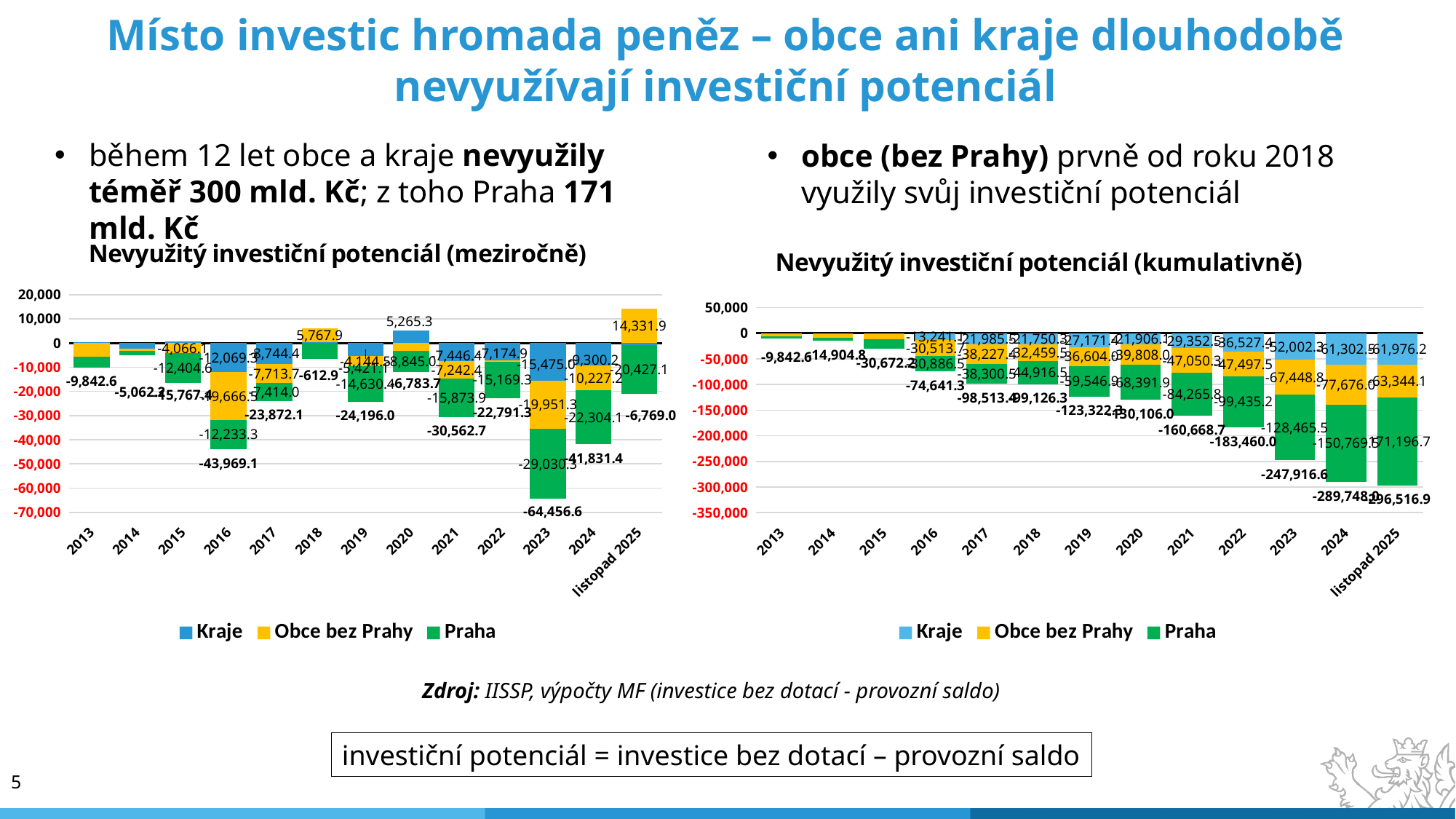
How many categories are shown on the x axis of the left chart 'Nevyužitý investiční potenciál (meziročně)'? 13 What kind of chart is the left chart titled 'Nevyužitý investiční potenciál (meziročně)'? stacked bar chart In the left chart 'Nevyužitý investiční potenciál (meziročně)', which year has the total closest to zero? 2018 How many series does the legend of the right chart 'Nevyužitý investiční potenciál (kumulativně)' list? 3 In the left chart 'Nevyužitý investiční potenciál (meziročně)', which is larger in magnitude: the total for 2016 or the total for 2024? 2016 In the right chart 'Nevyužitý investiční potenciál (kumulativně)', what is the total value labelled for listopad 2025? -296,516.9 In the left chart 'Nevyužitý investiční potenciál (meziročně)', what is the value of the Obce bez Prahy segment for listopad 2025? 14,331.9 In the right chart 'Nevyužitý investiční potenciál (kumulativně)', what is the value of the Praha segment for 2024? -150,769.5 In the left chart 'Nevyužitý investiční potenciál (meziročně)', which year has the lowest (most negative) total? 2023 In the left chart 'Nevyužitý investiční potenciál (meziročně)', what is the total value labelled for 2023? -64,456.6 In the right chart 'Nevyužitý investiční potenciál (kumulativně)', do the total values rise or fall from 2013 to listopad 2025? fall